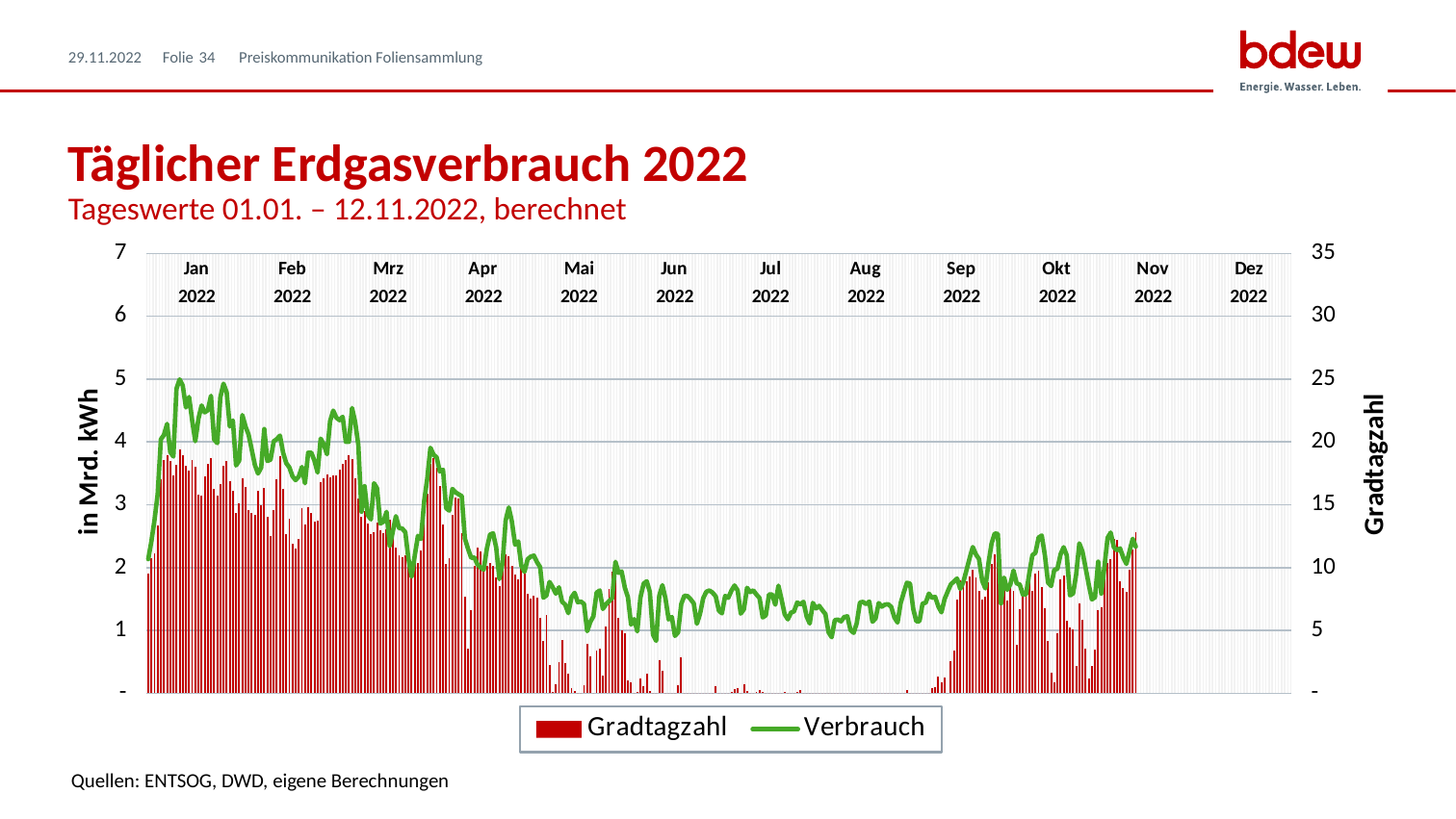
Does the Verbrauch line generally rise or fall from August to November? Rise What kind of chart is shown on the slide? A combined bar and line chart Is the Verbrauch line higher in January or in July? January Which series is drawn as red bars according to the legend? Gradtagzahl In which month does the Verbrauch line reach its highest values? January Does the Verbrauch line generally rise or fall from January to August? Fall Are the Gradtagzahl bars in July greater or less than 5 on the right axis? less How many series does the legend list? 2 What is the title of the chart? Täglicher Erdgasverbrauch 2022 Is the Verbrauch line in August greater or less than 2 on the left axis? less Is the peak value of the Verbrauch line in January greater or less than 4 on the left axis? greater How many month labels are shown along the x axis? 12